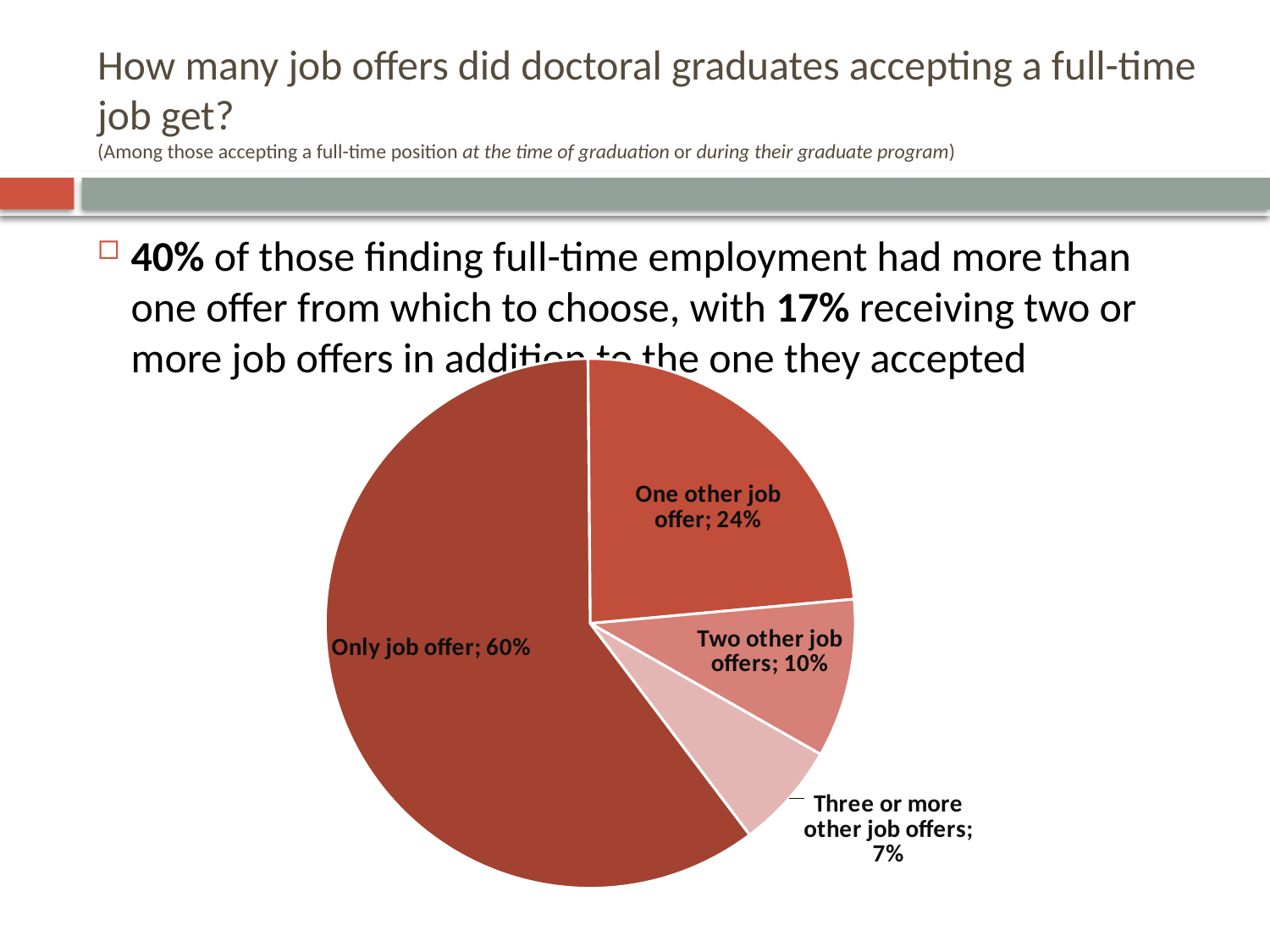
What kind of chart is shown on the slide? Pie chart Which is larger: the share for "Two other job offers" or "Three or more other job offers"? Two other job offers Is the "Only job offer" slice more or less than half of the pie? more Which slice of the pie is the smallest? Three or more other job offers What percentage of graduates had one other job offer? 24% What is the difference in percentage points between "Only job offer" and "One other job offer"? 36 How many slices does the pie chart have? 4 What percentage of graduates had two other job offers? 10% What percentage of graduates had three or more other job offers? 7% Which slice of the pie is the largest? Only job offer What share of the pie is labelled "Only job offer"? 60% What is the combined percentage for "Two other job offers" and "Three or more other job offers"? 17%